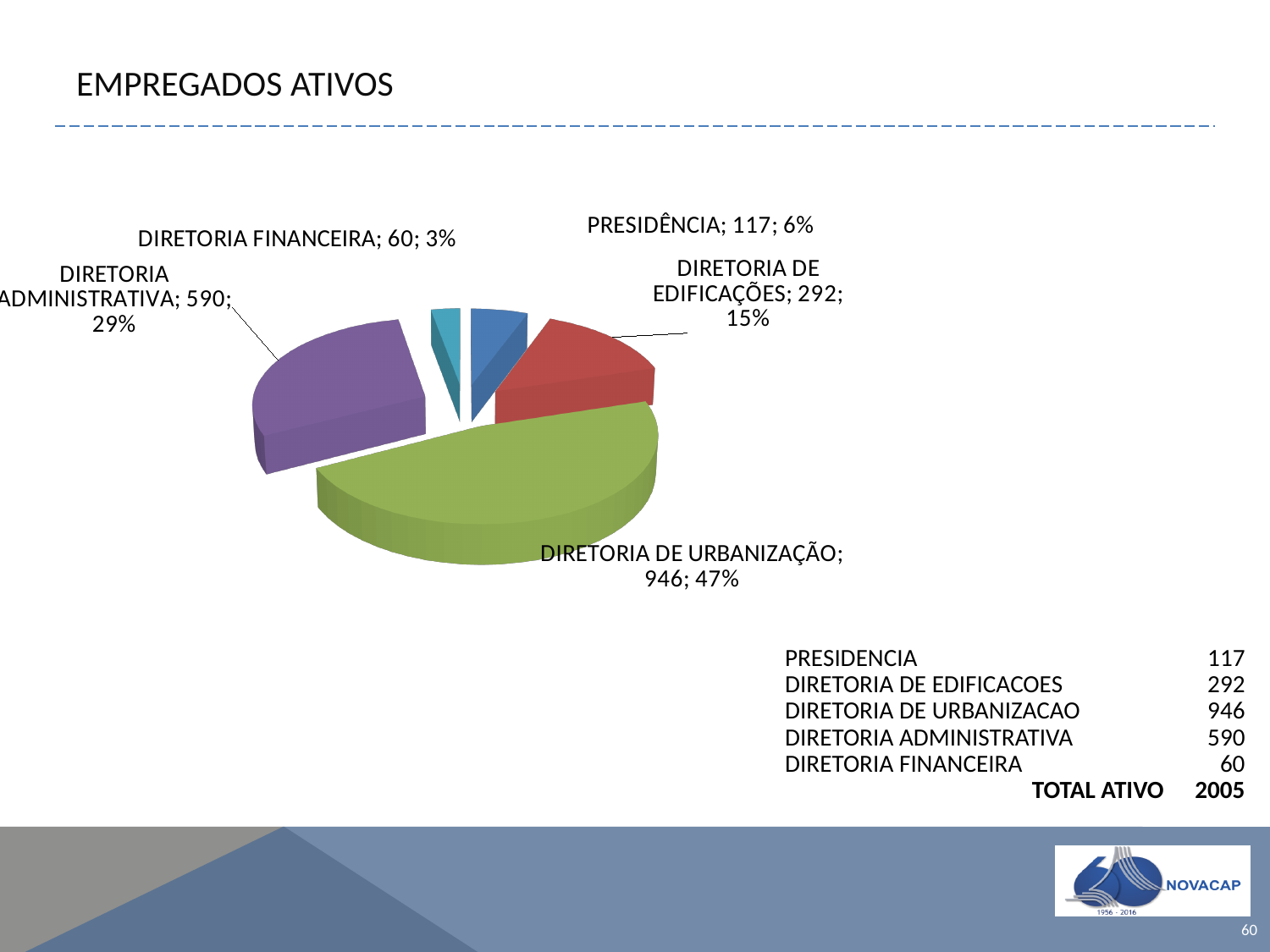
Which category has the smallest slice? DIRETORIA FINANCEIRA What share of the pie does DIRETORIA ADMINISTRATIVA represent? 29% What is the value for PRESIDÊNCIA? 117 What is the difference between the values for DIRETORIA ADMINISTRATIVA and DIRETORIA DE EDIFICAÇÕES? 298 What is the value for DIRETORIA DE EDIFICAÇÕES? 292 What is the title of the chart? EMPREGADOS ATIVOS What is the value for DIRETORIA DE URBANIZAÇÃO? 946 Which is larger, the value for PRESIDÊNCIA or the value for DIRETORIA FINANCEIRA? PRESIDÊNCIA What share of the pie does DIRETORIA FINANCEIRA represent? 3% What kind of chart is shown on the slide? Pie chart How many slices does the pie chart have? 5 Which category has the largest slice? DIRETORIA DE URBANIZAÇÃO